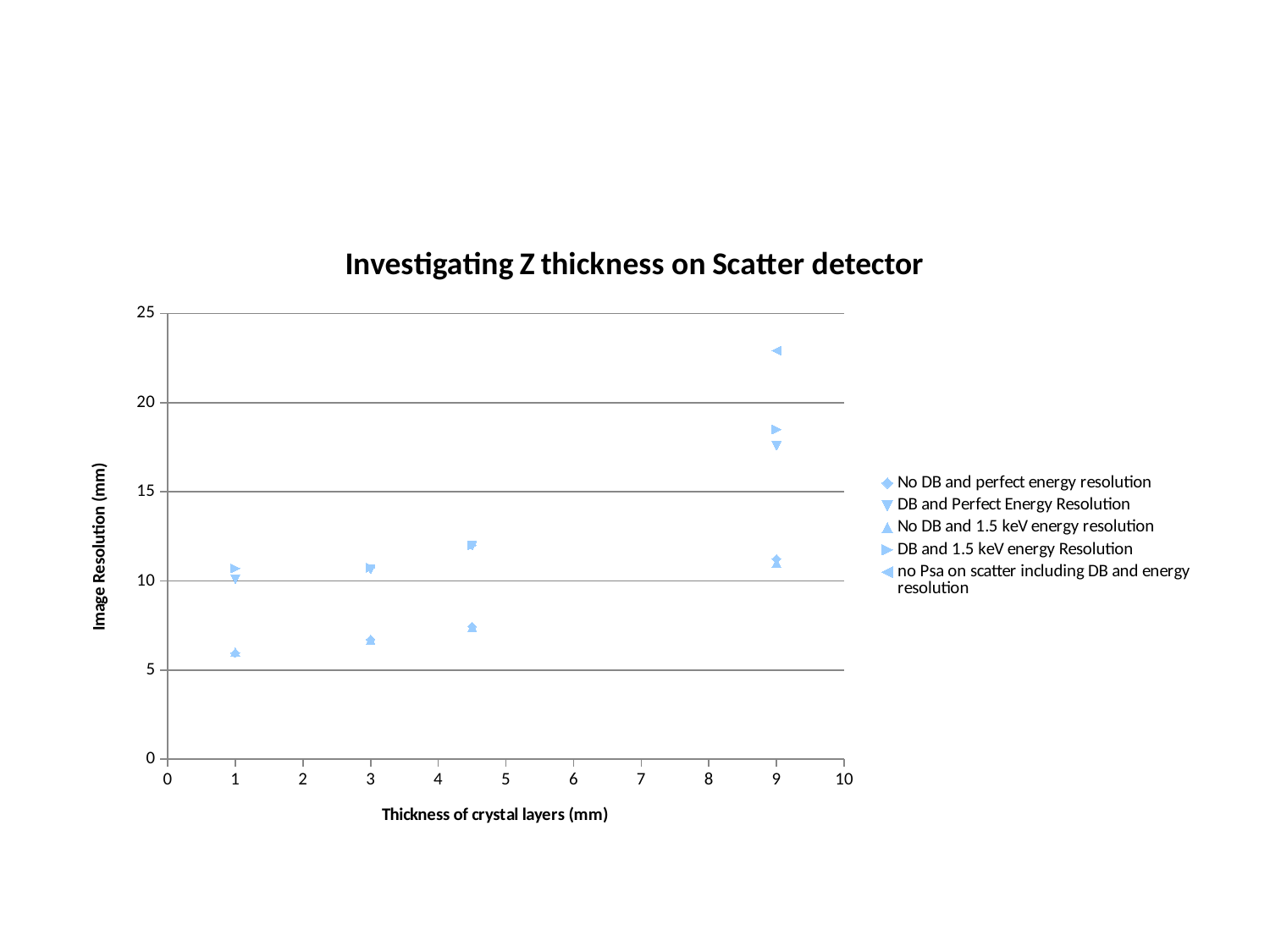
What kind of chart is shown on the slide? scatter chart What is the label of the x axis? Thickness of crystal layers (mm) How many series does the legend list? 5 At a thickness of 9 mm, which is larger: the value for 'no Psa on scatter including DB and energy resolution' or the value for 'DB and 1.5 keV energy Resolution'? no Psa on scatter including DB and energy resolution Is the value for 'DB and 1.5 keV energy Resolution' at a thickness of 9 mm greater or less than 15? greater Is the value for 'DB and Perfect Energy Resolution' at a thickness of 1 mm greater or less than 15? less Is the value for 'No DB and perfect energy resolution' at a thickness of 1 mm greater or less than 10? less Which series contains the highest plotted point on the chart? no Psa on scatter including DB and energy resolution How many points are plotted for the 'no Psa on scatter including DB and energy resolution' series? 1 What is the title of the chart? Investigating Z thickness on Scatter detector Does the image resolution for 'DB and 1.5 keV energy Resolution' rise or fall as the thickness of crystal layers increases? rises